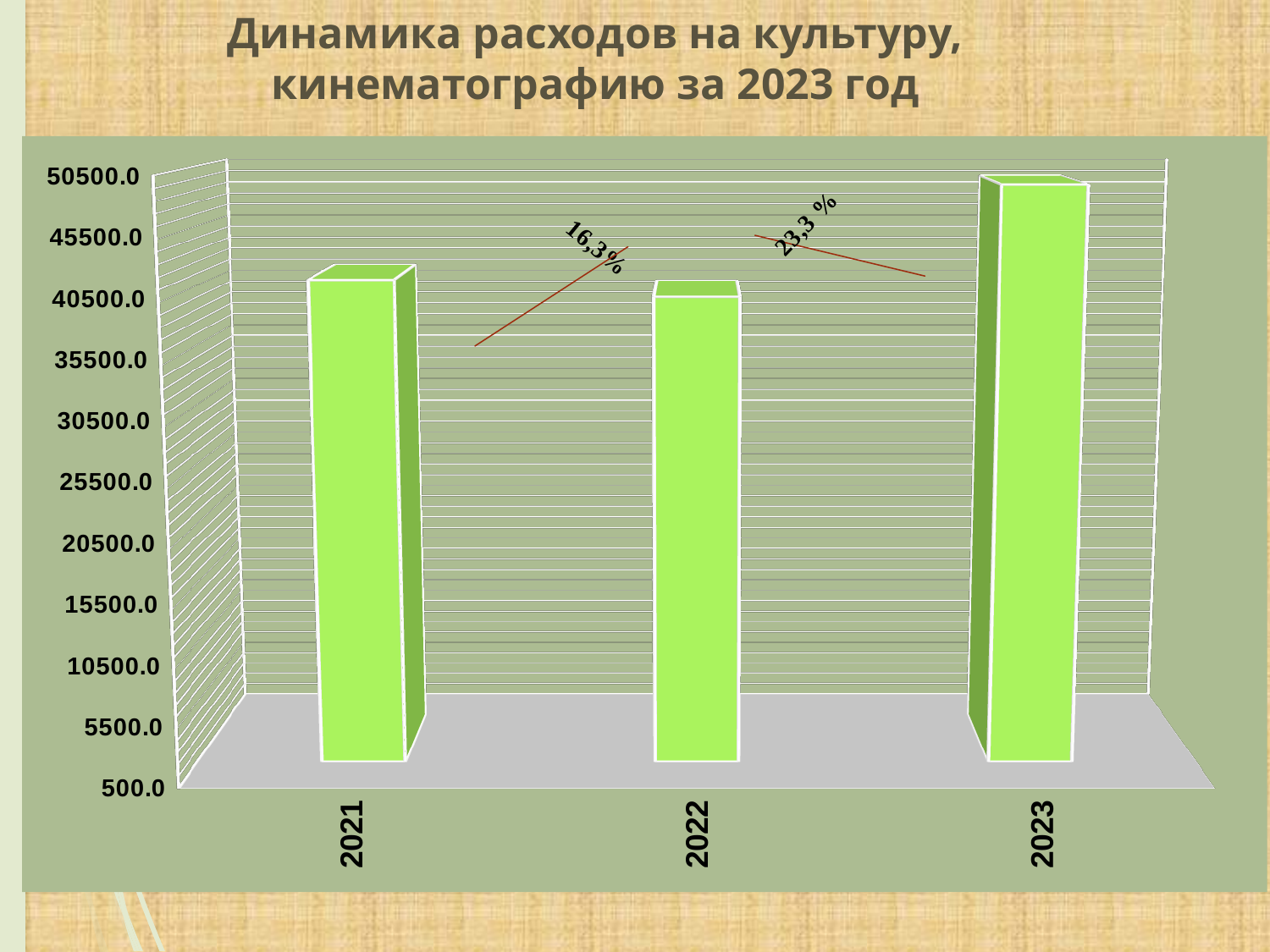
Is the value for 2023 greater or less than 45500.0? greater Which is larger, the value for 2022 or the value for 2023? 2023 Is the value for 2021 greater or less than 35500.0? greater Is the value for 2022 greater or less than 45500.0? less What is the title of the chart on the slide? Динамика расходов на культуру, кинематографию за 2023 год Which is larger, the value for 2021 or the value for 2022? 2021 Does the value rise or fall from 2022 to 2023? rises What kind of chart is shown on the slide? Bar chart What percentage annotation is written above the 2022 bar, between 2022 and 2023? 23,3 % Which year has the highest value on the chart? 2023 How many years (categories) are plotted on the chart? 3 Which year has the lowest value on the chart? 2022